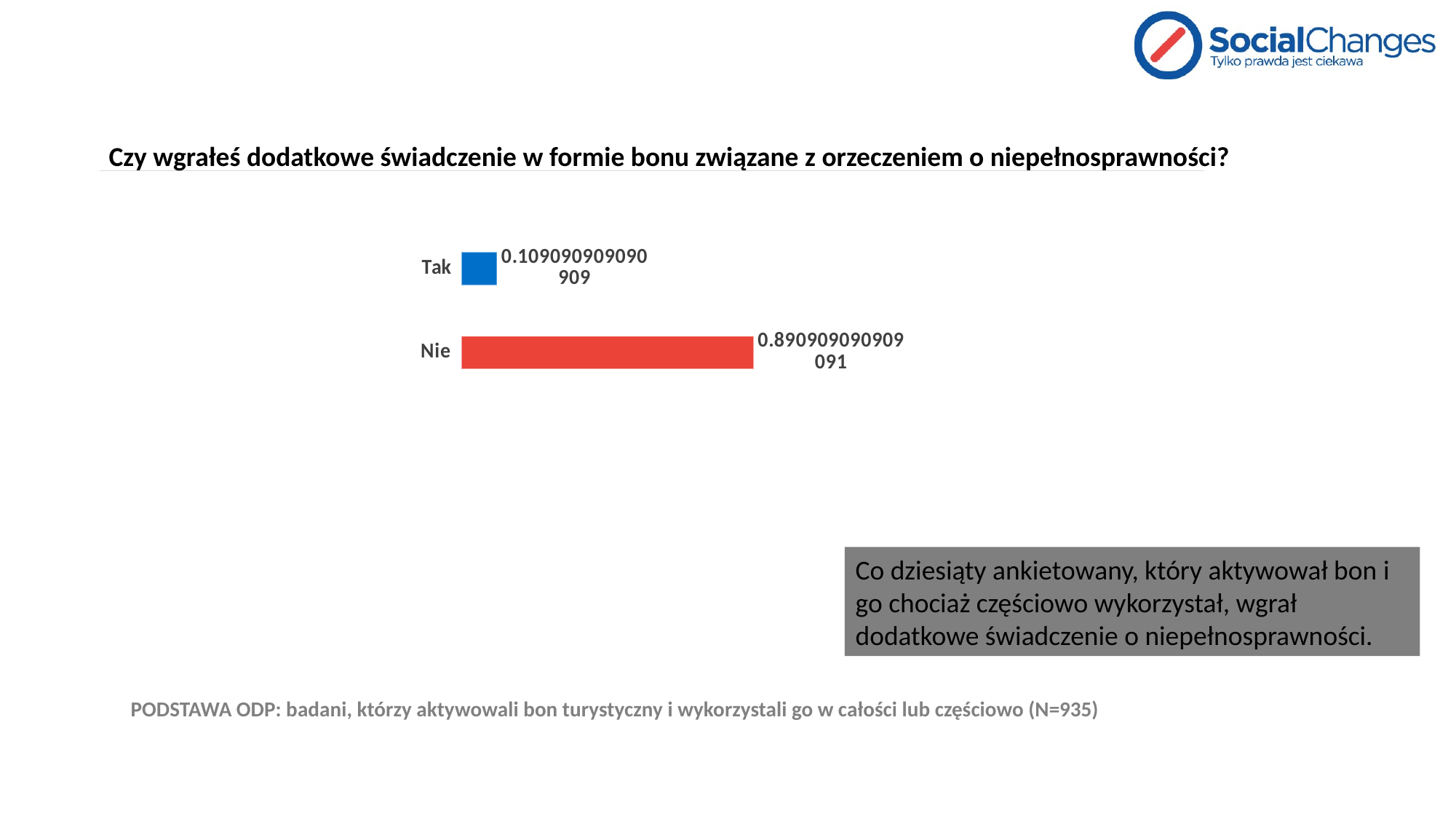
What is the difference between the value for "Nie" and the value for "Tak"? 0.781818181818182 How many categories are shown in the chart? 2 What colour is the bar for "Tak"? Blue What is the value shown for "Nie"? 0.890909090909091 Which is larger, the value for "Tak" or the value for "Nie"? Nie Which category has the highest value? Nie Which category has the lowest value? Tak What kind of chart is shown on the slide? Bar chart What is the value shown for "Tak"? 0.109090909090909 What colour is the bar for "Nie"? Red